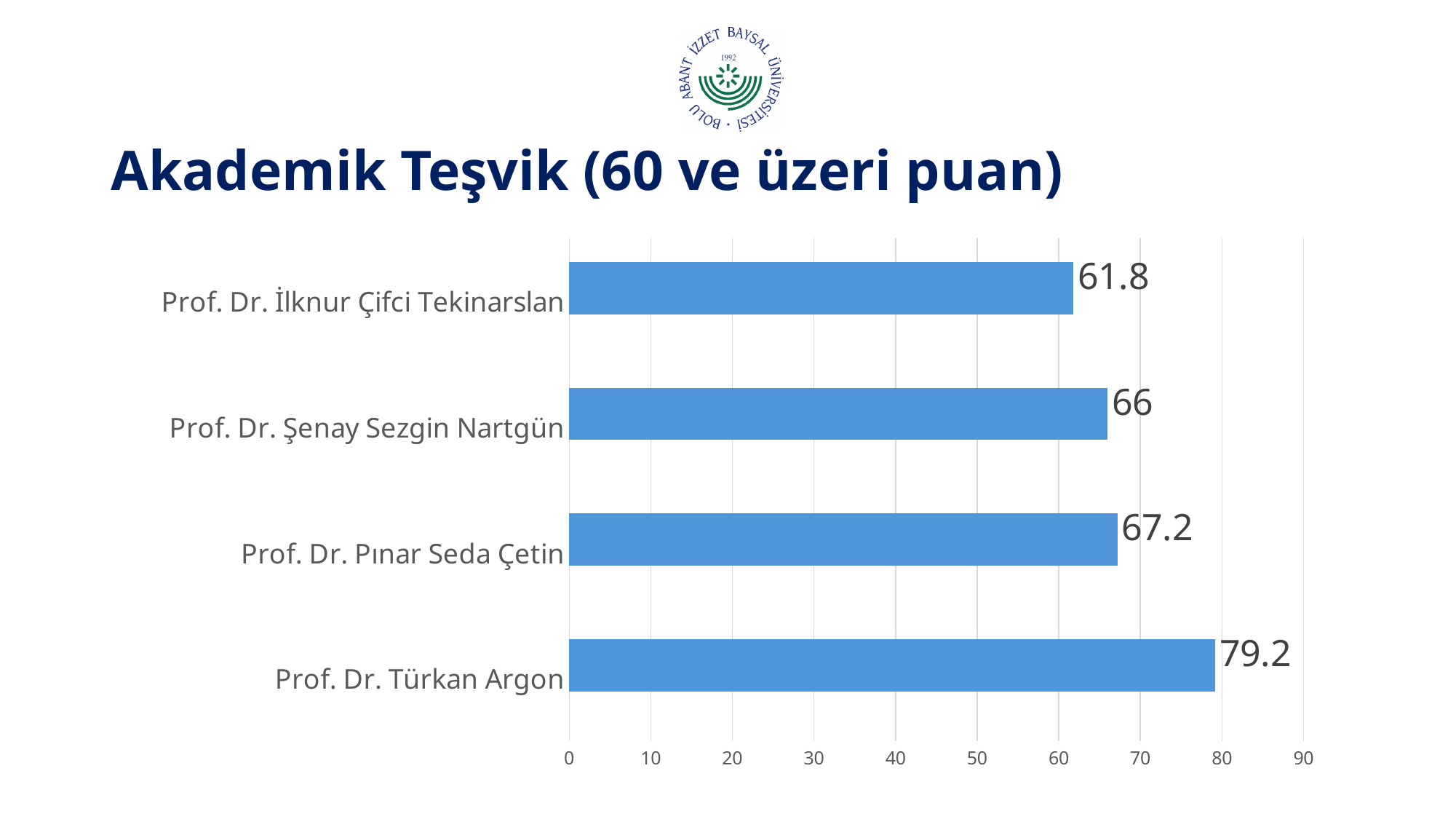
What is the value for Prof. Dr. Şenay Sezgin Nartgün? 66 What is the value for Prof. Dr. Pınar Seda Çetin? 67.2 Which person has the highest value? Prof. Dr. Türkan Argon Is the value for Prof. Dr. Türkan Argon greater or less than 70? greater What is the difference between the values for Prof. Dr. Pınar Seda Çetin and Prof. Dr. Şenay Sezgin Nartgün? 1.2 What is the value for Prof. Dr. Türkan Argon? 79.2 What kind of chart is shown on the slide? Bar chart How many people are shown in the chart? 4 Which is larger, the value for Prof. Dr. Pınar Seda Çetin or the value for Prof. Dr. Şenay Sezgin Nartgün? Prof. Dr. Pınar Seda Çetin What is the difference between the values for Prof. Dr. Türkan Argon and Prof. Dr. İlknur Çifci Tekinarslan? 17.4 What is the value for Prof. Dr. İlknur Çifci Tekinarslan? 61.8 Which person has the lowest value? Prof. Dr. İlknur Çifci Tekinarslan